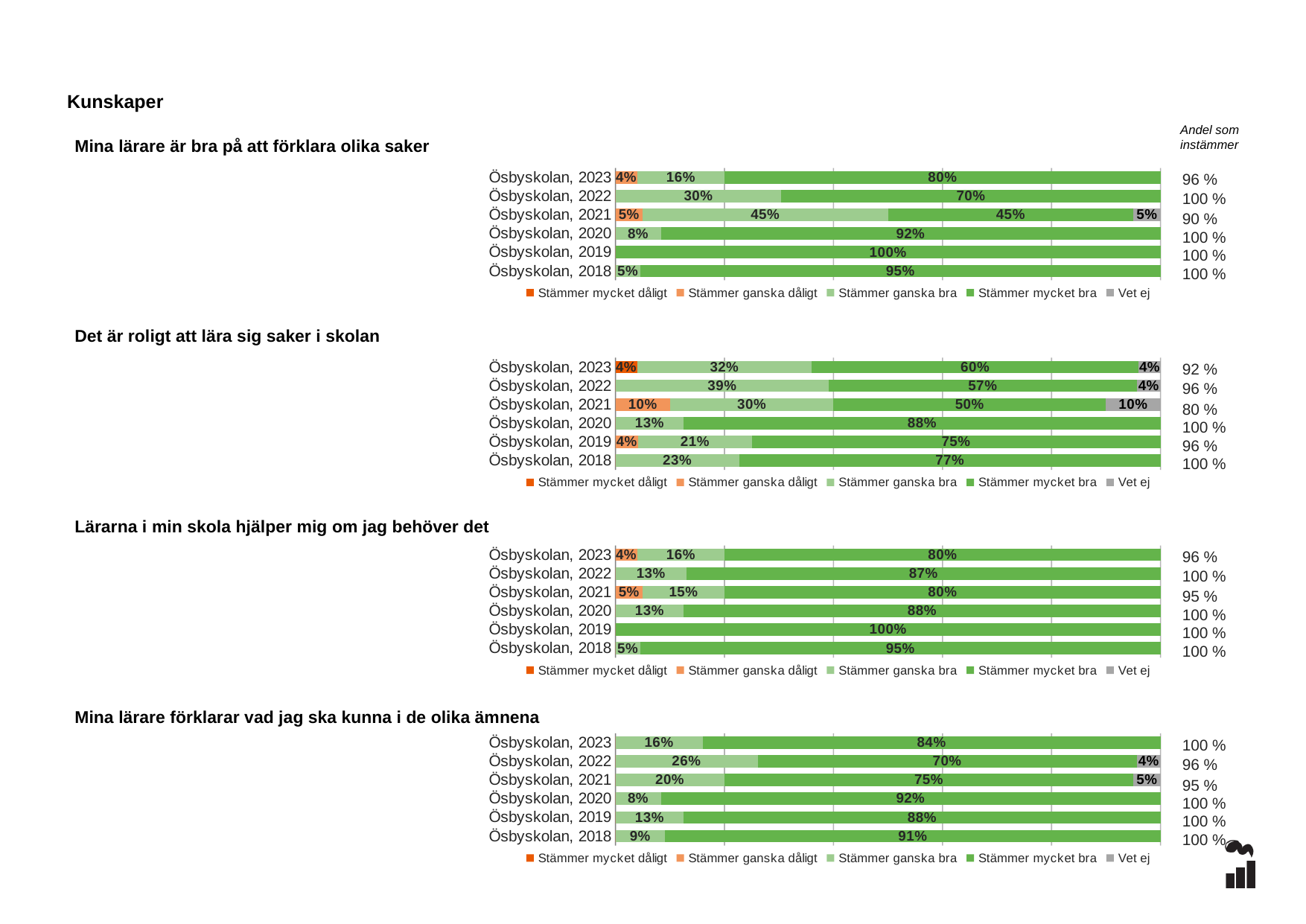
In the chart 'Det är roligt att lära sig saker i skolan', what is the 'Stämmer ganska dåligt' value for Ösbyskolan, 2019? 4% In the chart 'Mina lärare är bra på att förklara olika saker', what is the 'Stämmer mycket bra' value for Ösbyskolan, 2022? 70% In the chart 'Det är roligt att lära sig saker i skolan', which year has the lowest 'Stämmer mycket bra' value? Ösbyskolan, 2021 How many series does the legend list for the chart 'Lärarna i min skola hjälper mig om jag behöver det'? 5 In the chart 'Det är roligt att lära sig saker i skolan', what is the 'Vet ej' value for Ösbyskolan, 2021? 10% In the chart 'Mina lärare är bra på att förklara olika saker', what is the 'Andel som instämmer' value for Ösbyskolan, 2021? 90 % In the chart 'Mina lärare förklarar vad jag ska kunna i de olika ämnena', what is the difference between the 'Stämmer mycket bra' values for Ösbyskolan, 2023 and Ösbyskolan, 2022? 14% What is the heading at the top of the slide above the four charts? Kunskaper In the chart 'Det är roligt att lära sig saker i skolan', which is larger: the 'Stämmer ganska bra' value for Ösbyskolan, 2022 or for Ösbyskolan, 2023? Ösbyskolan, 2022 What kind of chart is 'Mina lärare förklarar vad jag ska kunna i de olika ämnena'? Stacked bar chart How many year categories are shown in the chart 'Mina lärare är bra på att förklara olika saker'? 6 In the chart 'Lärarna i min skola hjälper mig om jag behöver det', which year has the highest 'Stämmer mycket bra' value? Ösbyskolan, 2019